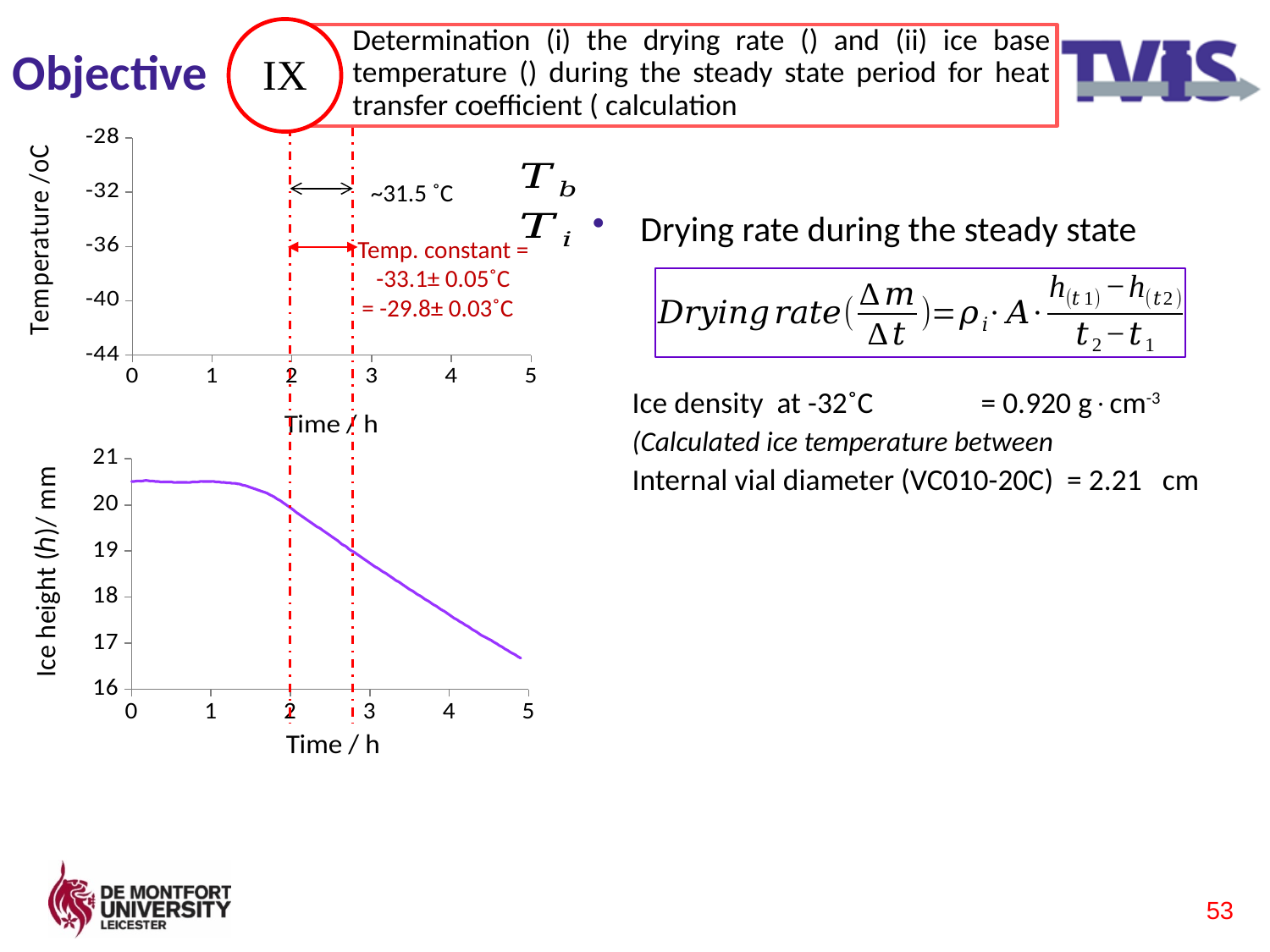
In the bottom chart (Ice height vs Time), at what time does the first red dashed vertical line appear? 2 In the bottom chart (Ice height vs Time), is the ice height at the end of the curve (near 5 h) greater or less than 17 mm? less In the bottom chart (Ice height vs Time), is the ice height at 0 h greater or less than 20 mm? greater In the bottom chart (Ice height vs Time), does the ice height rise or fall as time increases from 2 h to 5 h? fall In the bottom chart (Ice height vs Time), is the ice height at 4 h greater or less than 18 mm? less What is the lowest value shown on the y axis of the top chart (Temperature vs Time)? -44 What is the maximum value shown on the y axis of the bottom chart (Ice height vs Time)? 21 What kind of chart is the bottom chart (Ice height vs Time)? line chart What is the label of the y axis of the top chart? Temperature /oC What is the label of the x axis of the bottom chart? Time / h In the bottom chart (Ice height vs Time), is the ice height higher at 1 h or at 4 h? 1 h